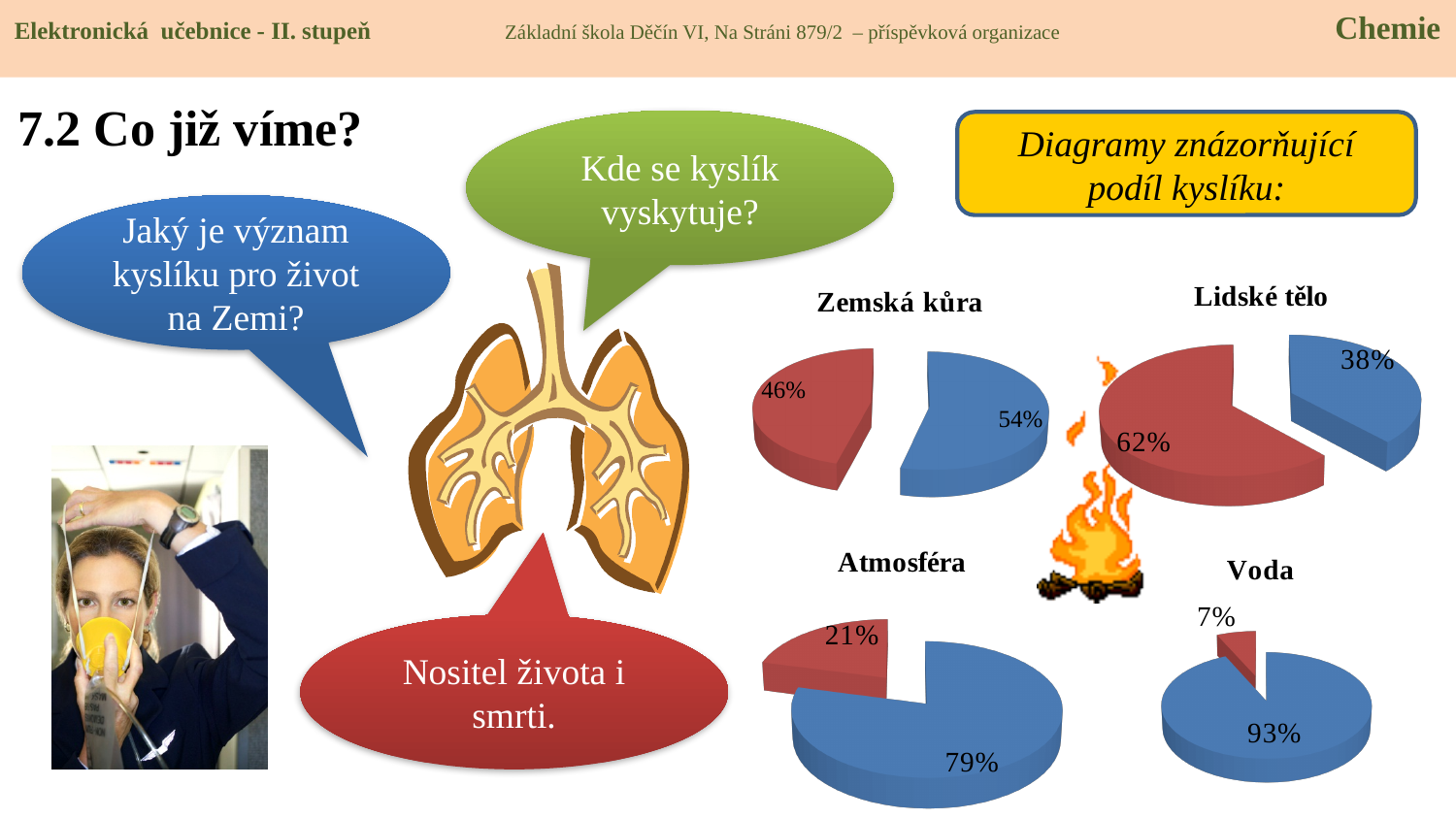
Which of the four pie charts has the largest red slice? Lidské tělo In the "Lidské tělo" chart, what value is shown on the red slice? 62% In the "Lidské tělo" chart, what value is shown on the blue slice? 38% How many pie charts are shown on the slide? 4 In the "Voda" chart, what value is shown on the blue slice? 93% Which of the four pie charts has the smallest red slice? Voda In the "Zemská kůra" chart, what value is shown on the blue slice? 54% What kind of chart is the "Zemská kůra" chart? pie chart In the "Voda" chart, what is the difference between the blue slice and the red slice? 86% In the "Atmosféra" chart, which slice is larger, the red one or the blue one? the blue one In the "Atmosféra" chart, what value is shown on the red slice? 21% In the "Zemská kůra" chart, what value is shown on the red slice? 46%